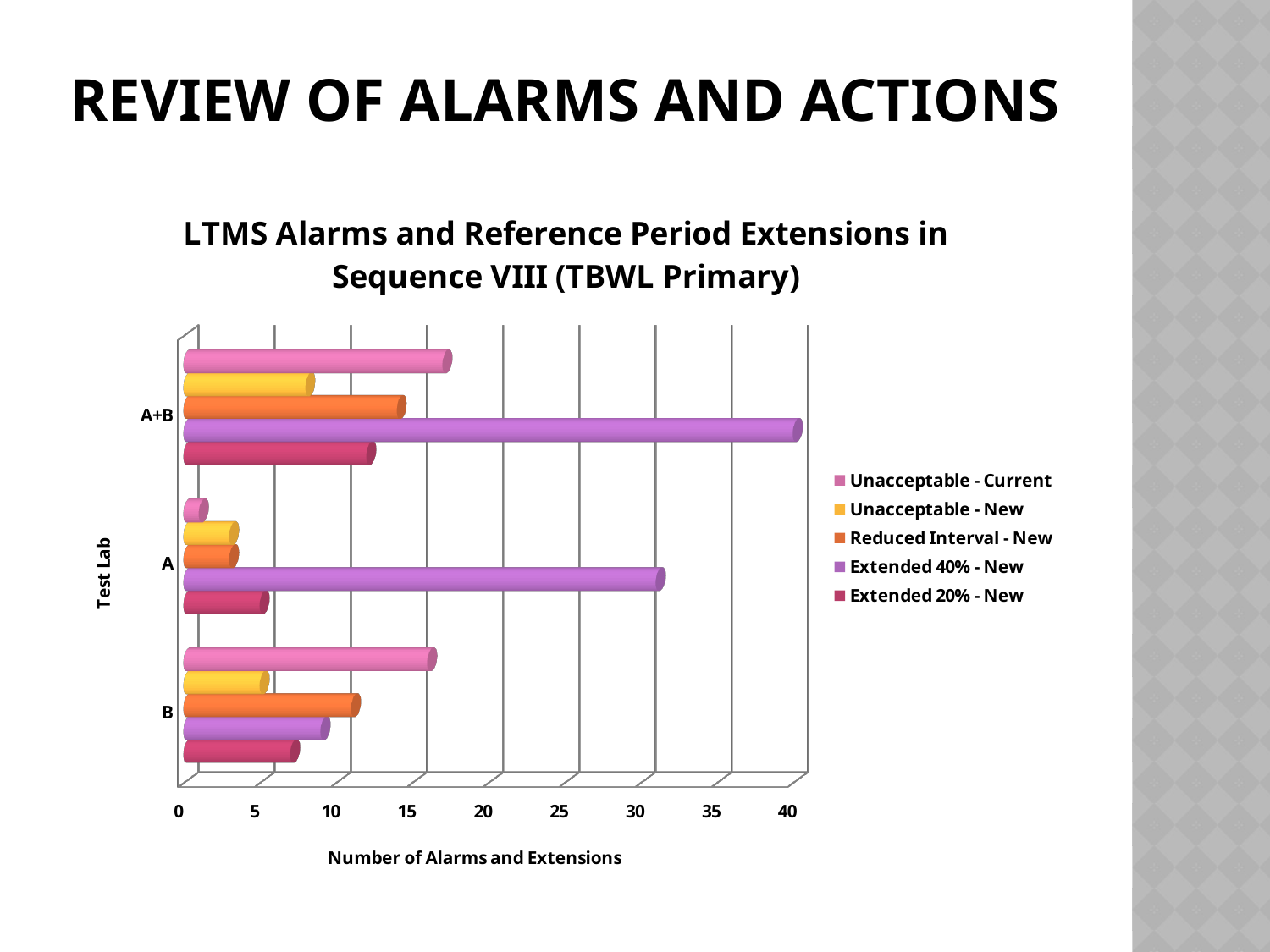
What is the title of the x axis? Number of Alarms and Extensions What kind of chart is shown on the slide? bar chart Is the value for Extended 40% - New for test lab B greater or less than 15? less Is the value for Extended 40% - New for test lab A+B greater or less than 35? greater Which test lab has the lowest value for Unacceptable - Current? A For test lab A+B, which is larger: Extended 40% - New or Extended 20% - New? Extended 40% - New Is the value for Unacceptable - Current for test lab A greater or less than 5? less How many series does the legend list? 5 For test lab B, which is larger: Unacceptable - Current or Reduced Interval - New? Unacceptable - Current How many test lab categories are shown on the y axis? 3 Which test lab has the highest value for Extended 40% - New? A+B